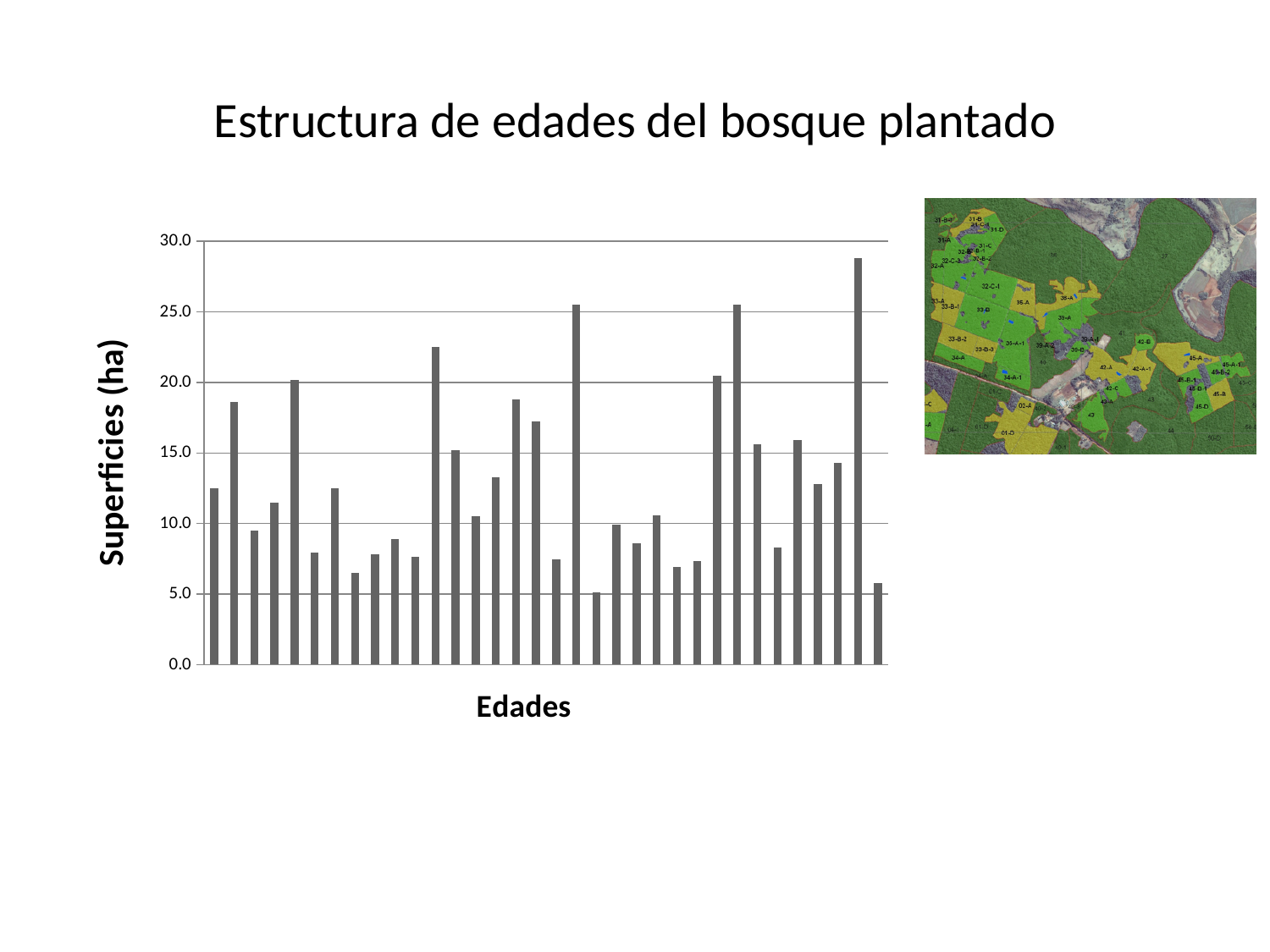
Is the value of the first (leftmost) bar in the chart greater or less than 10.0? greater Is the value of the shortest bar in the chart greater or less than 10.0? less What is the title of the horizontal axis of the chart? Edades Which is larger, the first bar from the left or the second bar from the left? the second bar from the left What kind of chart is shown on the slide? bar chart What is the title of the vertical axis of the chart? Superficies (ha) Is the value of the last (rightmost) bar in the chart greater or less than 10.0? less Where is the tallest bar located in the chart? second bar from the right